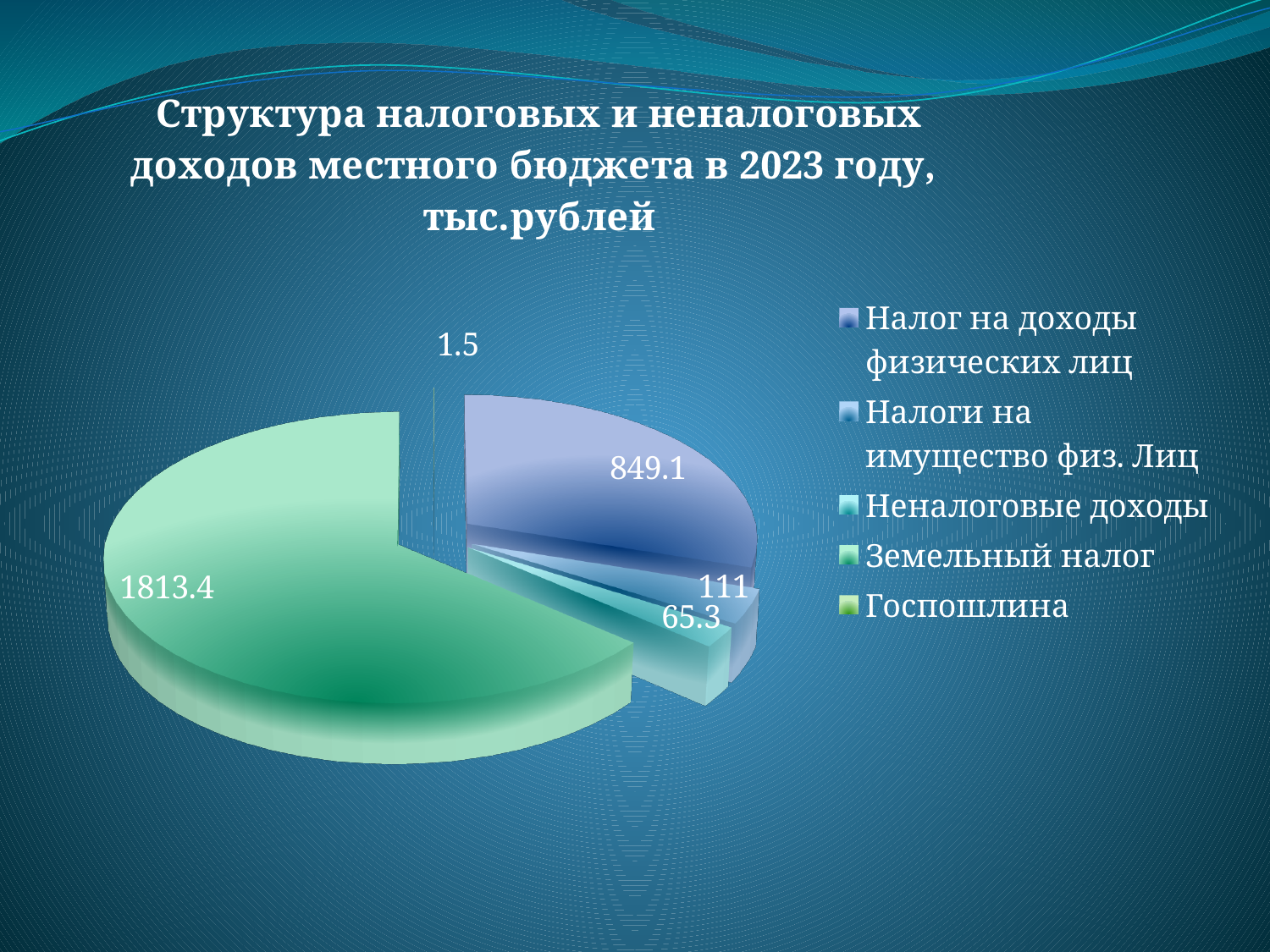
Which category has the smallest slice of the pie? Госпошлина Which is larger: Налоги на имущество физ. Лиц or Неналоговые доходы? Налоги на имущество физ. Лиц How many categories does the pie chart show? 5 What is the value for Налог на доходы физических лиц? 849.1 What is the value for Земельный налог? 1813.4 What is the value for Госпошлина? 1.5 What is the title of the chart? Структура налоговых и неналоговых доходов местного бюджета в 2023 году, тыс.рублей What is the difference between the values for Земельный налог and Налог на доходы физических лиц? 964.3 What kind of chart is shown on the slide? Pie chart Which category has the largest slice of the pie? Земельный налог What is the value for Налоги на имущество физ. Лиц? 111 What is the value for Неналоговые доходы? 65.3